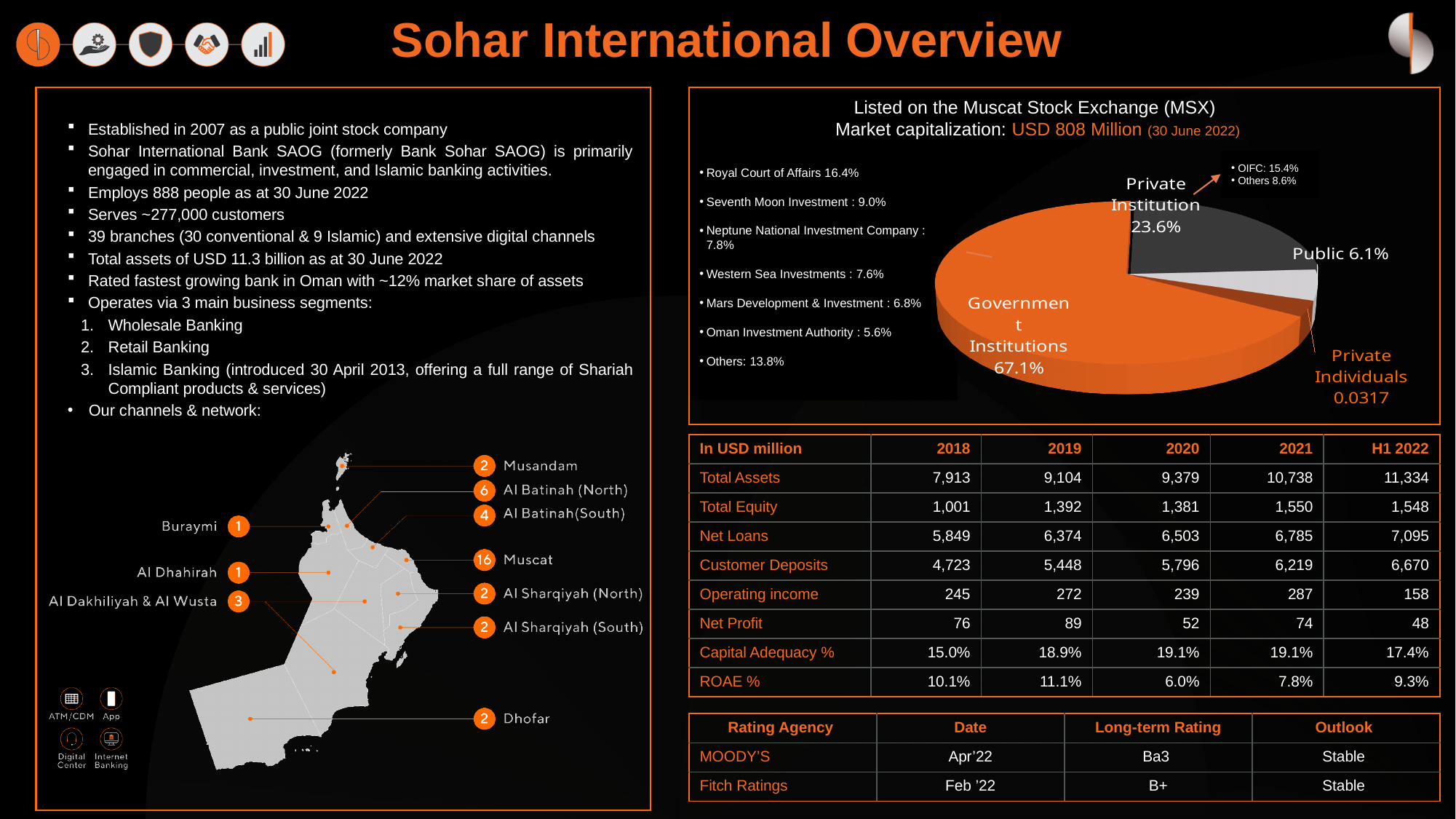
In the shareholding pie chart, which category holds the largest share? Government Institutions In the shareholding pie chart, what share is held by Private Institution? 23.6% What colour is the Government Institutions slice in the shareholding pie chart? Orange What kind of chart is used to show the shareholding structure on the slide? Pie chart In the shareholding pie chart, which is larger: Private Institution or Public? Private Institution How many slices does the shareholding pie chart have? 4 In the callout breaking down the Private Institution slice of the pie chart, what share is attributed to OIFC? 15.4% In the shareholding pie chart, what share is labelled Public? 6.1% In the shareholding pie chart, what share is held by Government Institutions? 67.1% In the shareholding pie chart, which category holds the smallest share? Private Individuals In the shareholding pie chart, how many percentage points larger is the Government Institutions share than the Private Institution share? 43.5 In the shareholding pie chart, how many percentage points larger is the Private Institution share than the Public share? 17.5